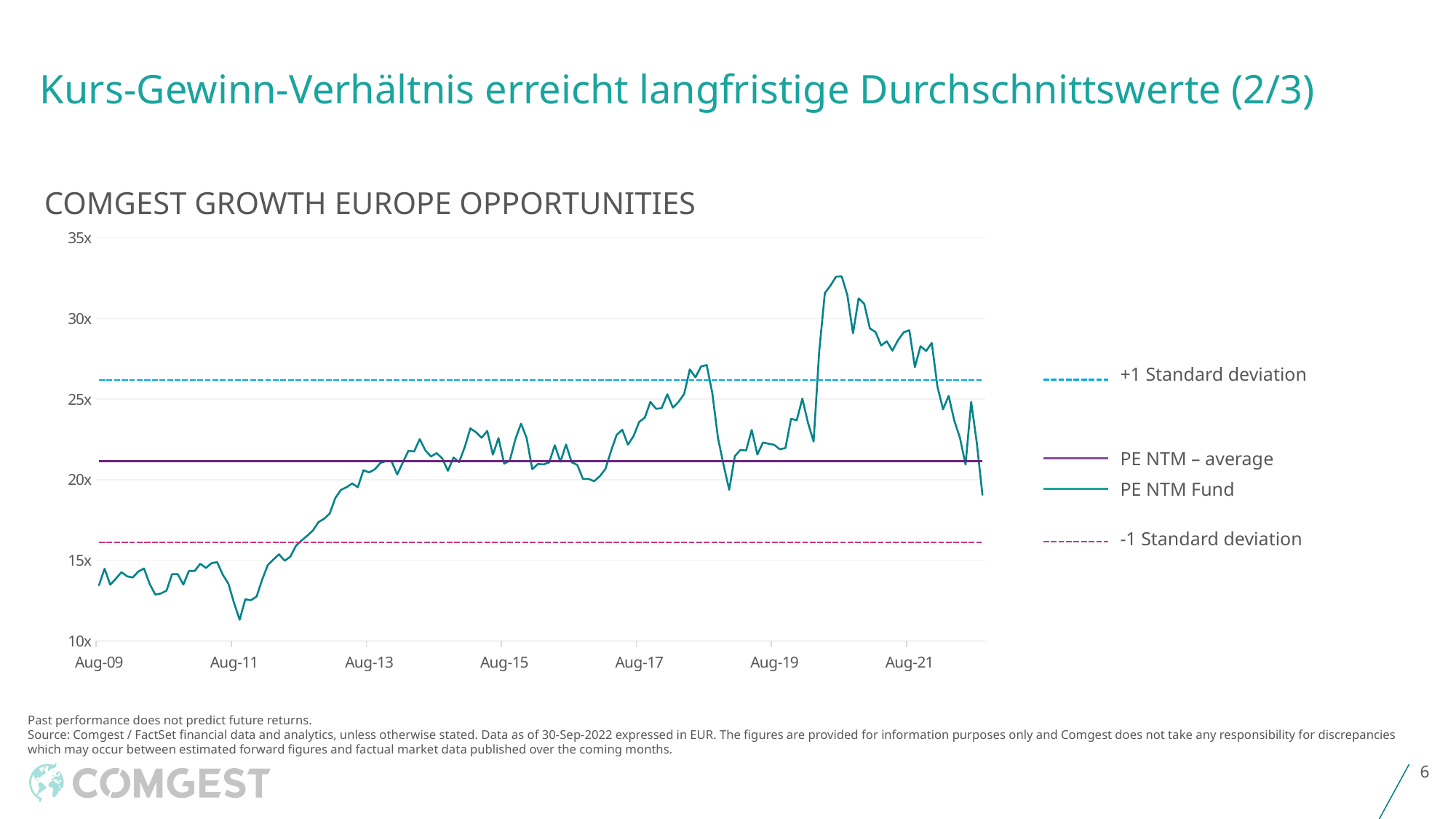
Is the +1 Standard deviation line greater or less than 25x? greater Is the peak of the PE NTM Fund line (around 2020) greater or less than 30x? greater Is the PE NTM – average line greater or less than 20x? greater How many labelled ticks are on the x axis? 7 What is the title printed above the chart? COMGEST GROWTH EUROPE OPPORTUNITIES What kind of chart is shown on the slide? line chart How many series does the legend list? 4 Does the PE NTM Fund line rise or fall between Aug-09 and Aug-13? rise Which legend entry is drawn as a solid purple line? PE NTM – average